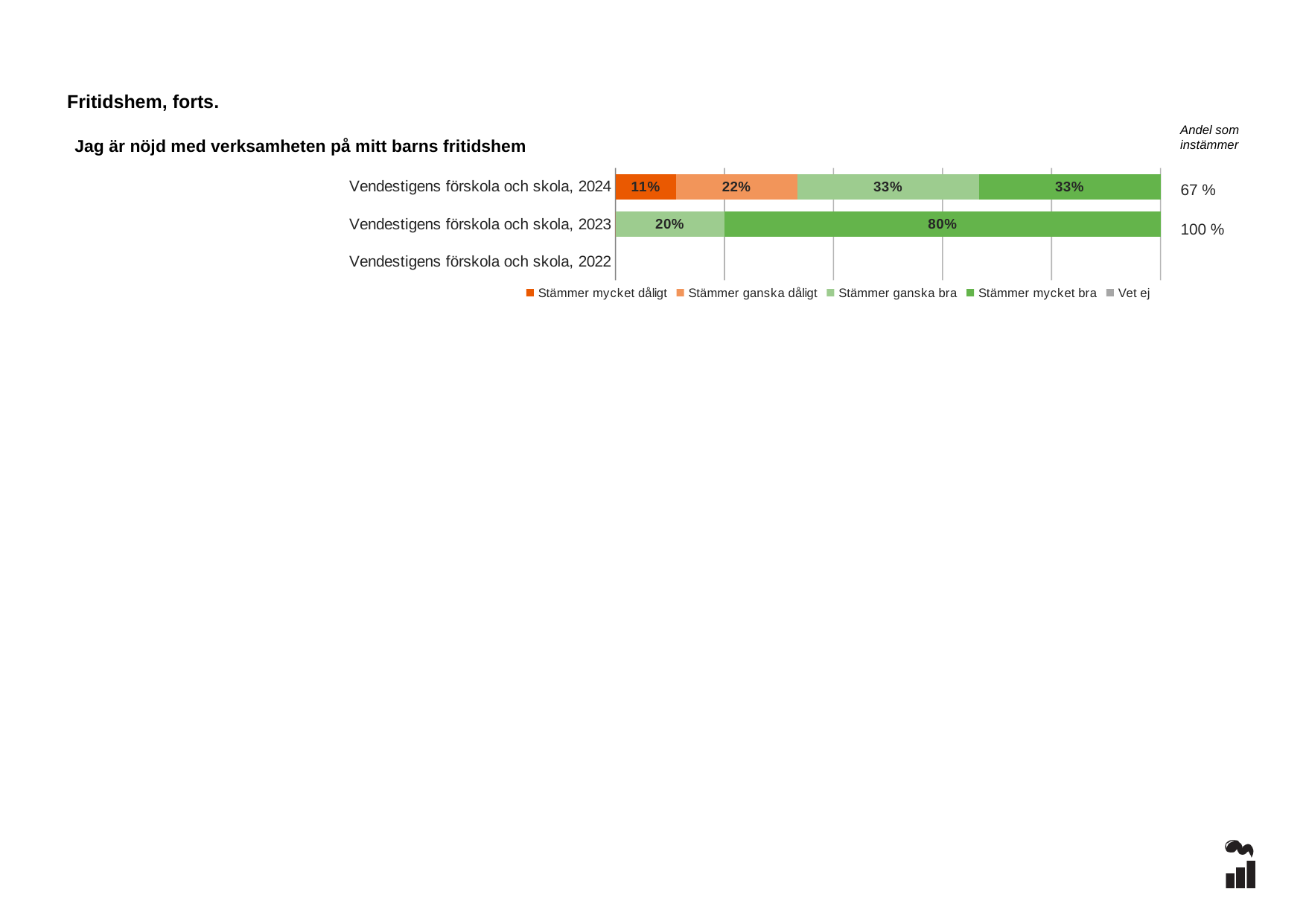
What is the value for "Stämmer mycket bra" for Vendestigens förskola och skola, 2023? 80% How many series does the legend list? 5 Which is larger: "Stämmer mycket bra" for 2023 or "Stämmer mycket bra" for 2024? 2023 What is the value for "Stämmer mycket dåligt" for Vendestigens förskola och skola, 2024? 11% How many category rows are listed on the y axis of the chart? 3 What is the difference between "Stämmer mycket bra" for 2023 and "Stämmer mycket bra" for 2024? 47% What is the "Andel som instämmer" value shown for Vendestigens förskola och skola, 2024? 67 % What is the value for "Stämmer ganska bra" for Vendestigens förskola och skola, 2023? 20% What kind of chart is shown on the slide? Stacked bar chart What is the value for "Stämmer ganska dåligt" for Vendestigens förskola och skola, 2024? 22% What is the title of the chart? Jag är nöjd med verksamheten på mitt barns fritidshem What is the "Andel som instämmer" value shown for Vendestigens förskola och skola, 2023? 100 %